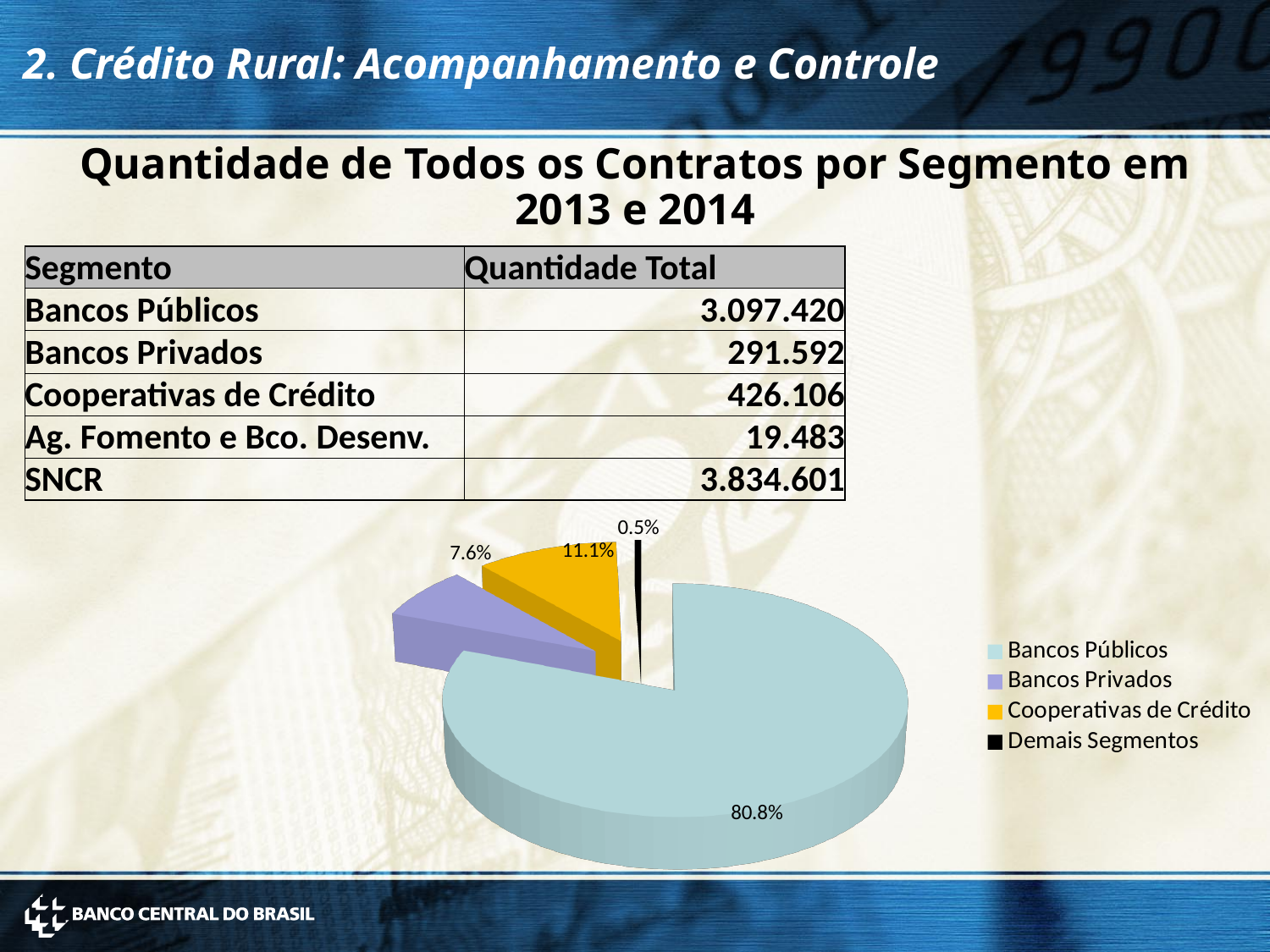
What is the difference in percentage points between the Cooperativas de Crédito slice and the Bancos Privados slice? 3.5 Which segment has the largest slice in the pie chart? Bancos Públicos What colour is the Cooperativas de Crédito slice in the pie chart? Yellow What kind of chart is shown on the slide? Pie chart How many slices does the pie chart have? 4 What percentage share does the Bancos Privados slice have in the pie chart? 7.6% What percentage share does the Bancos Públicos slice have in the pie chart? 80.8% How many entries does the legend of the pie chart list? 4 Which segment has the smallest slice in the pie chart? Demais Segmentos Which slice is larger in the pie chart, Cooperativas de Crédito or Bancos Privados? Cooperativas de Crédito What percentage share does the Cooperativas de Crédito slice have in the pie chart? 11.1% What percentage share does the Demais Segmentos slice have in the pie chart? 0.5%